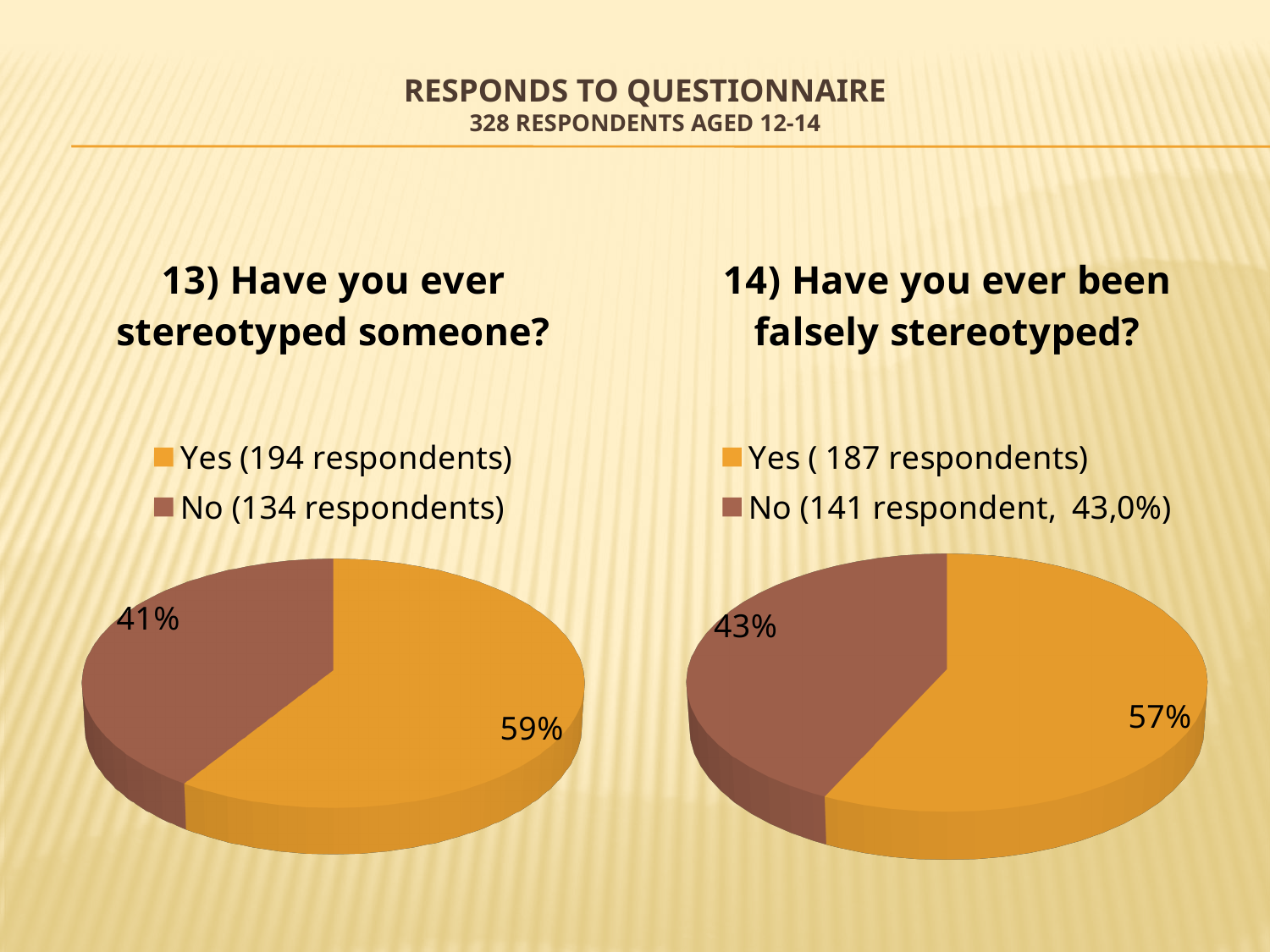
In the chart titled "14) Have you ever been falsely stereotyped?", what percentage is shown for the Yes slice? 57% In the chart titled "13) Have you ever stereotyped someone?", how many respondents does the legend give for the No answer? 134 respondents What kind of chart is the chart titled "13) Have you ever stereotyped someone?"? Pie chart In the chart titled "13) Have you ever stereotyped someone?", what is the difference in percentage points between the Yes and No slices? 18 In the chart titled "13) Have you ever stereotyped someone?", what percentage is shown for the Yes slice? 59% In the chart titled "13) Have you ever stereotyped someone?", what percentage is shown for the No slice? 41% Is the Yes slice larger in the chart titled "13) Have you ever stereotyped someone?" or in the chart titled "14) Have you ever been falsely stereotyped?"? 13) Have you ever stereotyped someone? In the chart titled "14) Have you ever been falsely stereotyped?", what is the difference in percentage points between the Yes and No slices? 14 In the chart titled "14) Have you ever been falsely stereotyped?", which slice is the smallest? No (141 respondent, 43,0%) In the chart titled "13) Have you ever stereotyped someone?", which slice is the largest? Yes (194 respondents) How many slices does the chart titled "14) Have you ever been falsely stereotyped?" have? 2 In the chart titled "14) Have you ever been falsely stereotyped?", what percentage is shown for the No slice? 43%